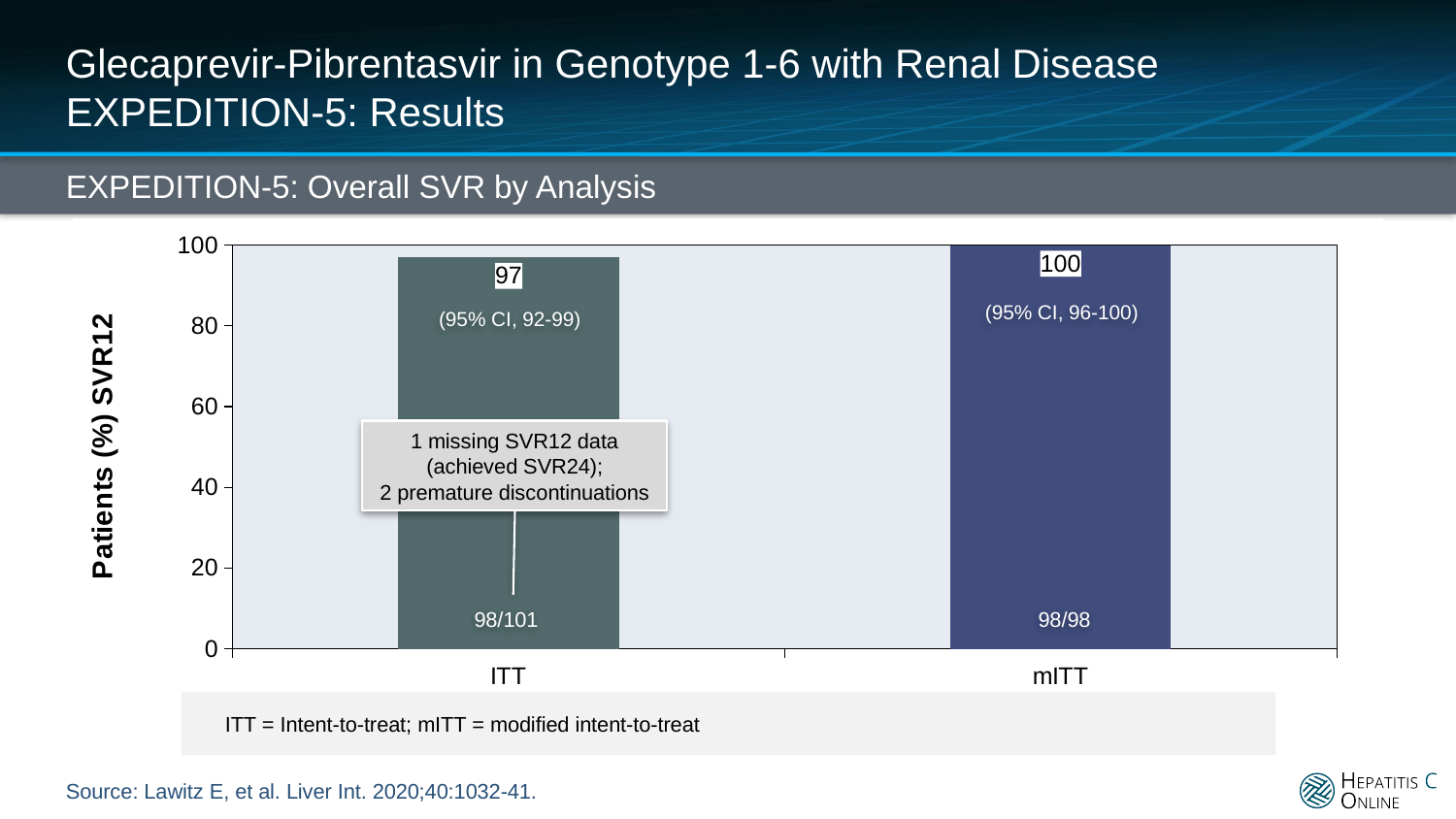
What is the difference in SVR12 rate (percentage points) between mITT and ITT? 3 What is the fraction of patients achieving SVR12 shown on the ITT bar? 98/101 What is the SVR12 rate (%) for the mITT analysis? 100 What is the 95% confidence interval shown for the ITT SVR12 rate? 92-99 What is the SVR12 rate (%) for the ITT analysis? 97 How many analysis groups are shown on the x axis? 2 What kind of chart is shown on the slide? Bar chart Which analysis group has the higher SVR12 rate? mITT Which analysis group has the lower SVR12 rate? ITT Is the SVR12 rate for ITT greater or less than 80? greater What is the fraction of patients achieving SVR12 shown on the mITT bar? 98/98 What is the label of the y axis? Patients (%) SVR12